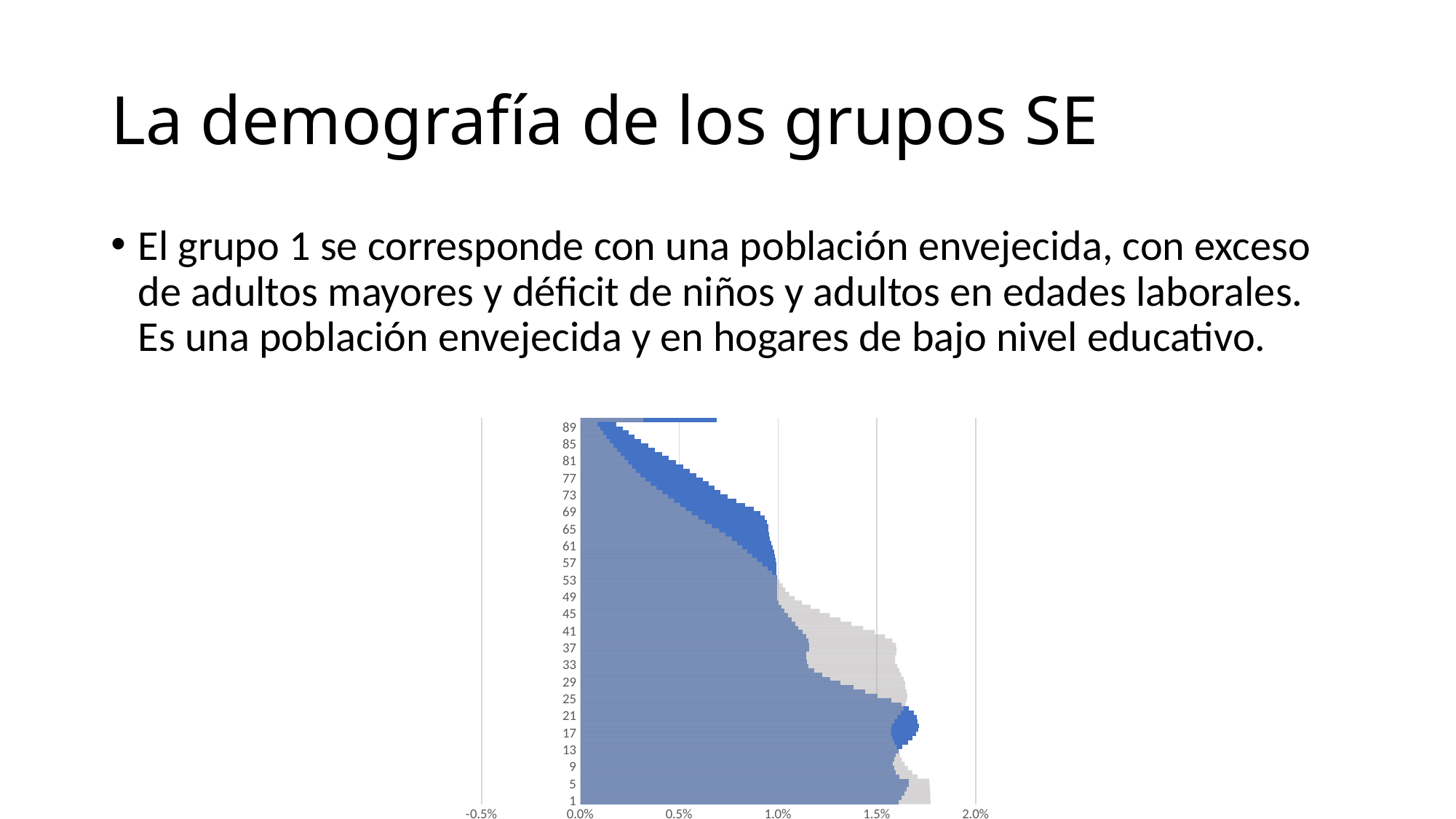
What is the lowest value labelled on the horizontal axis of the chart? -0.5% Do the blue bars generally get longer or shorter as age increases from 1 to 89? shorter What kind of chart is shown on the slide? bar chart Is the blue bar for age 85 greater or less than 0.5%? less Is the blue bar for age 69 greater or less than 1.0%? less Is the grey bar for age 1 greater or less than 1.5%? greater How many differently coloured series of bars are plotted in the chart? 2 At age 69, which bar is longer, the blue one or the grey one? blue At age 41, which bar is longer, the blue one or the grey one? grey